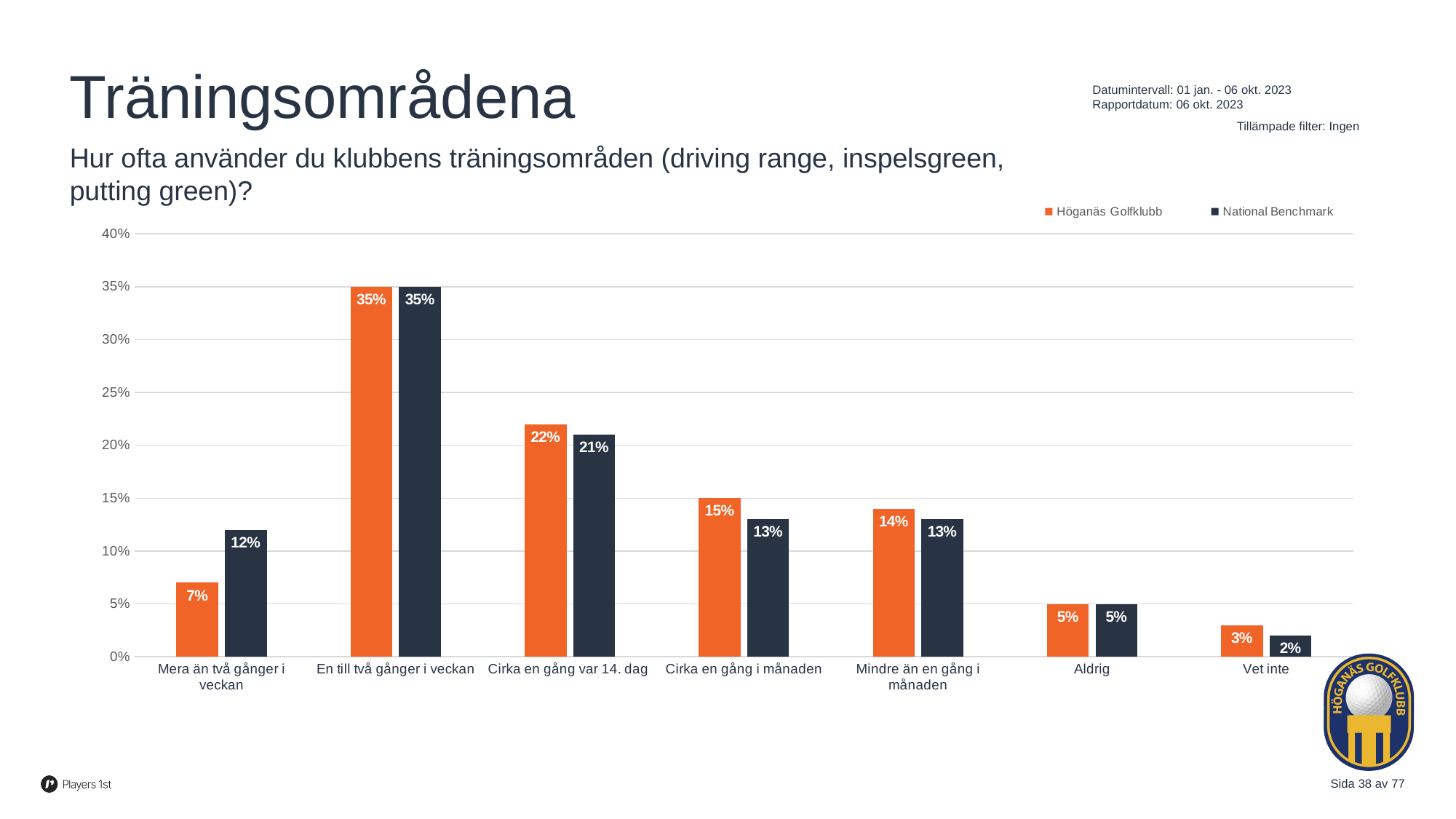
Which category has the lowest National Benchmark value? Vet inte What is the difference between the Höganäs Golfklubb and National Benchmark values for "Mera än två gånger i veckan"? 5% What is the National Benchmark value for "Mera än två gånger i veckan"? 12% What kind of chart is shown on the slide? Bar chart How many categories are shown on the x axis? 7 How many series does the legend list? 2 What is the Höganäs Golfklubb value for "Vet inte"? 3% What is the Höganäs Golfklubb value for "En till två gånger i veckan"? 35% Is the Höganäs Golfklubb value for "Cirka en gång var 14. dag" greater or less than 20%? greater Which colour represents National Benchmark in the chart? Dark navy Which category has the highest Höganäs Golfklubb value? En till två gånger i veckan Which is larger for "Cirka en gång i månaden": Höganäs Golfklubb or National Benchmark? Höganäs Golfklubb